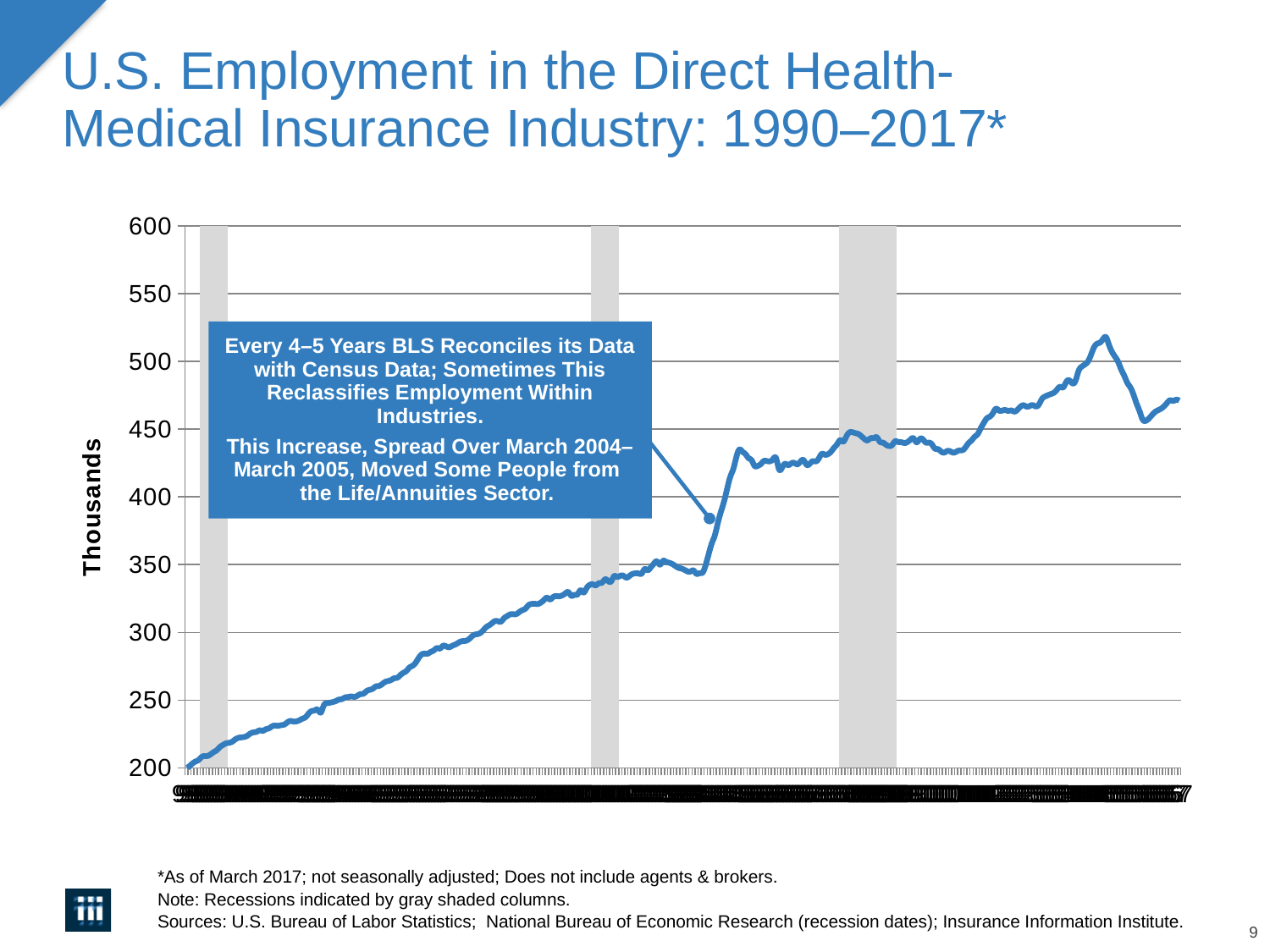
Is the highest point of the line greater or less than 500? greater What kind of chart is shown on the slide? line chart Overall, do the values rise or fall from the left of the x axis to the right? rise Is the lowest point of the line greater or less than 250? less Is the value at the end of the series (right end of the line) greater or less than 450? greater According to the note on the slide, what do the gray shaded columns indicate? Recessions What is the label on the vertical axis? Thousands How many lines are plotted on the chart? 1 How many gray shaded recession columns are shown on the chart? 3